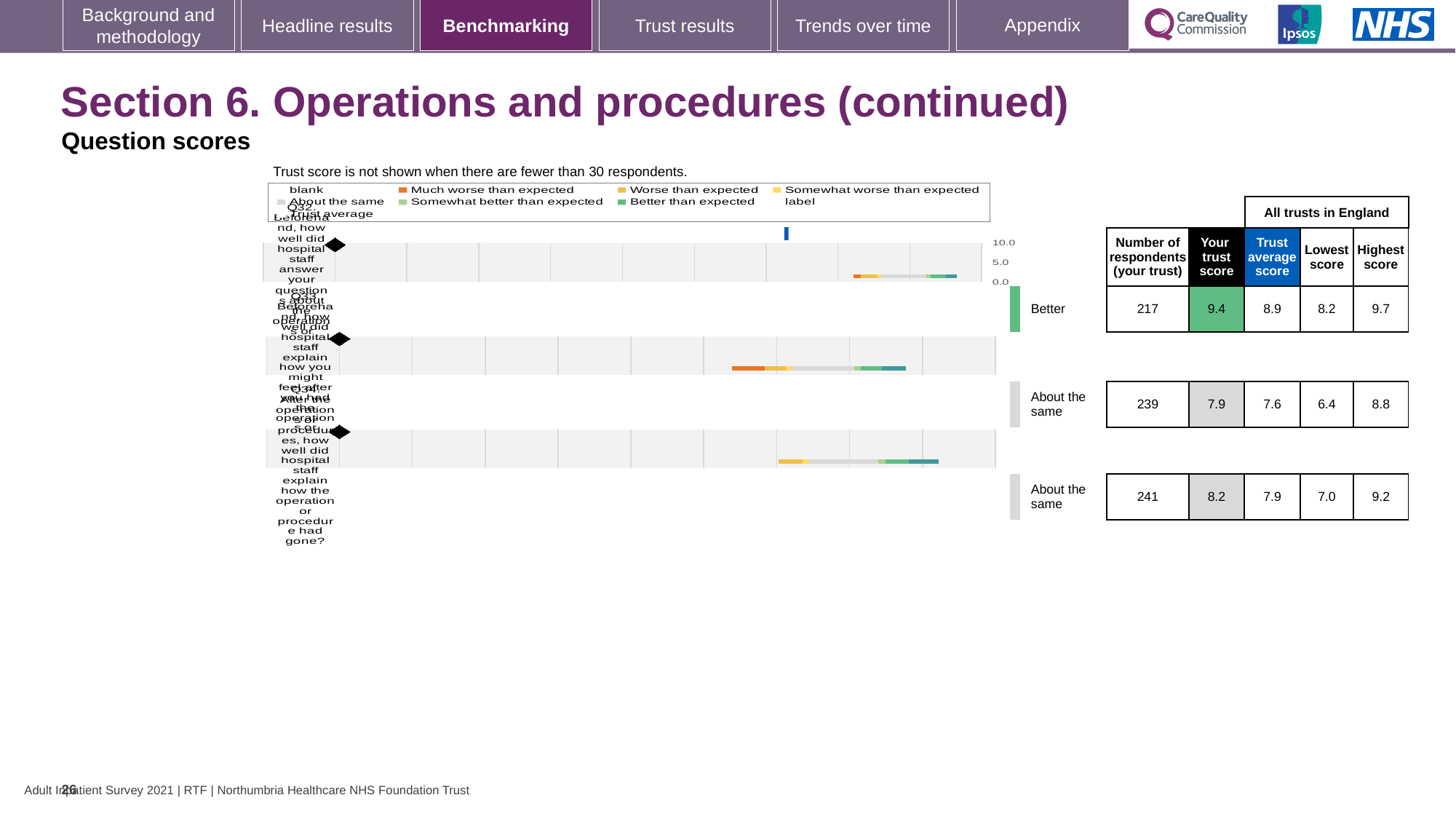
What kind of chart is shown on the slide? bar chart In the table beside the chart, what is the difference between the trust score and the trust average score for the row labelled 'Better'? 0.5 In the table beside the chart, what is the trust score for the row labelled 'Better'? 9.4 Which row in the table beside the chart has the lowest 'Your trust score'? the row with 239 respondents How many question rows does the chart show? 3 Which row in the table beside the chart has the highest 'Your trust score'? the row labelled 'Better' (217 respondents) In the table beside the chart, what is the lowest score for the row with 239 respondents? 6.4 In the table beside the chart, what is the trust average score for the row with 239 respondents? 7.6 What is the highest tick value shown on the chart's score axis? 10.0 In the table beside the chart, what is the highest score for the row with 241 respondents? 9.2 In the table beside the chart, is the trust score for the row with 241 respondents larger or smaller than the trust score for the row with 239 respondents? larger In the table beside the chart, how many respondents are in the row labelled 'Better'? 217